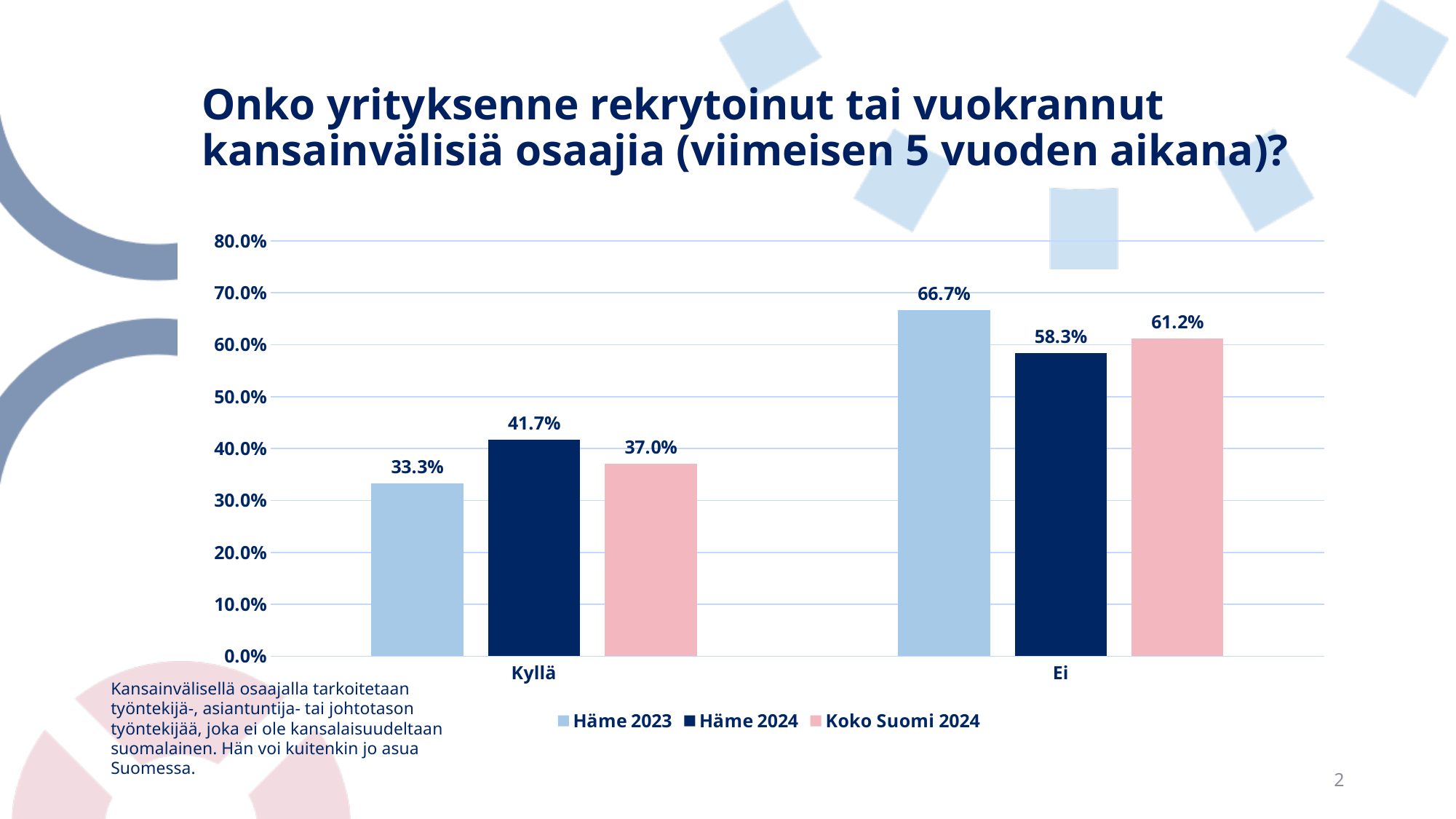
Which is larger: Häme 2024 for Kyllä or Koko Suomi 2024 for Kyllä? Häme 2024 for Kyllä What is the value for Häme 2024 in the Ei category? 58.3% What is the difference between the Häme 2023 values for Ei and Kyllä? 33.4% Which series has the highest value in the Ei category? Häme 2023 What is the value for Häme 2023 in the Kyllä category? 33.3% Which series has the lowest value in the Kyllä category? Häme 2023 Which series is shown in pink in the legend? Koko Suomi 2024 How many categories are shown on the x axis? 2 What is the value for Koko Suomi 2024 in the Kyllä category? 37.0% How many series does the legend list? 3 What kind of chart is shown on the slide? Bar chart Is the value for Koko Suomi 2024 in the Ei category greater or less than 60.0%? greater